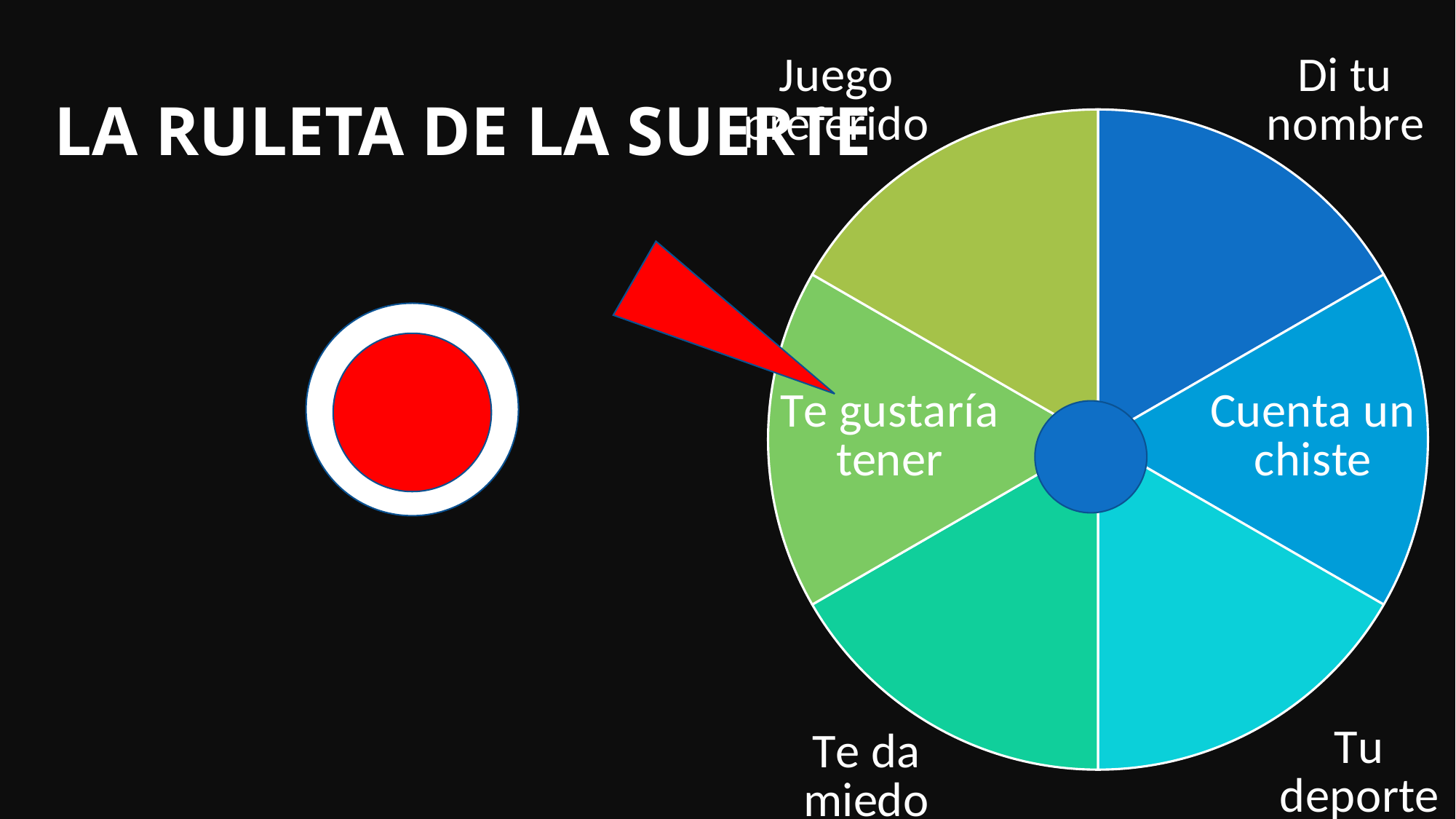
How many slices does the pie chart have? 6 What is the title of the slide containing the pie chart? LA RULETA DE LA SUERTE Which slice label is written inside the medium blue slice on the right side of the pie chart? Cuenta un chiste Which slice of the pie chart is the red pointer pointing at? Te gustaría tener Which slice label appears at the bottom left of the pie chart, next to the teal-green slice? Te da miedo Which slice label appears at the bottom right of the pie chart, next to the light cyan slice? Tu deporte What kind of chart is shown on the slide? Pie chart Which slice label appears at the top right of the pie chart, next to the dark blue slice? Di tu nombre